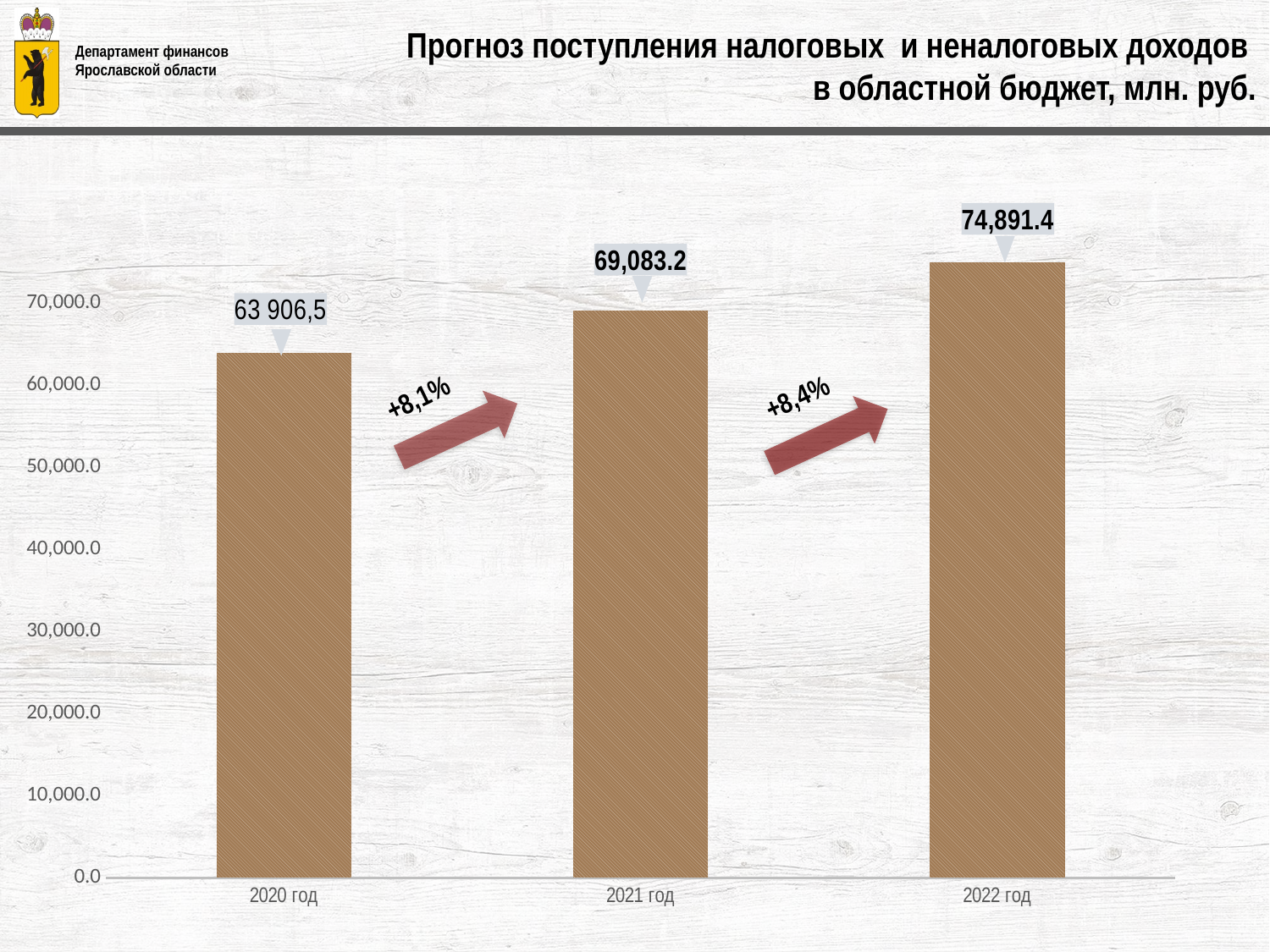
Which year has the highest forecast value? 2022 год What is the difference between the values for 2022 год and 2021 год? 5,808.2 Which is larger, the value for 2020 год or the value for 2021 год? 2021 год What is the value shown for 2020 год? 63 906,5 What is the forecast value for 2021 год? 69,083.2 What kind of chart is shown on the slide? bar chart What percentage growth is shown by the arrow between 2021 год and 2022 год? +8,4% Which year has the lowest forecast value? 2020 год What is the difference between the values for 2021 год and 2020 год? 5,176.7 Is the value for 2022 год greater or less than 70,000.0? greater How many years are shown on the chart? 3 What is the forecast value for 2022 год? 74,891.4